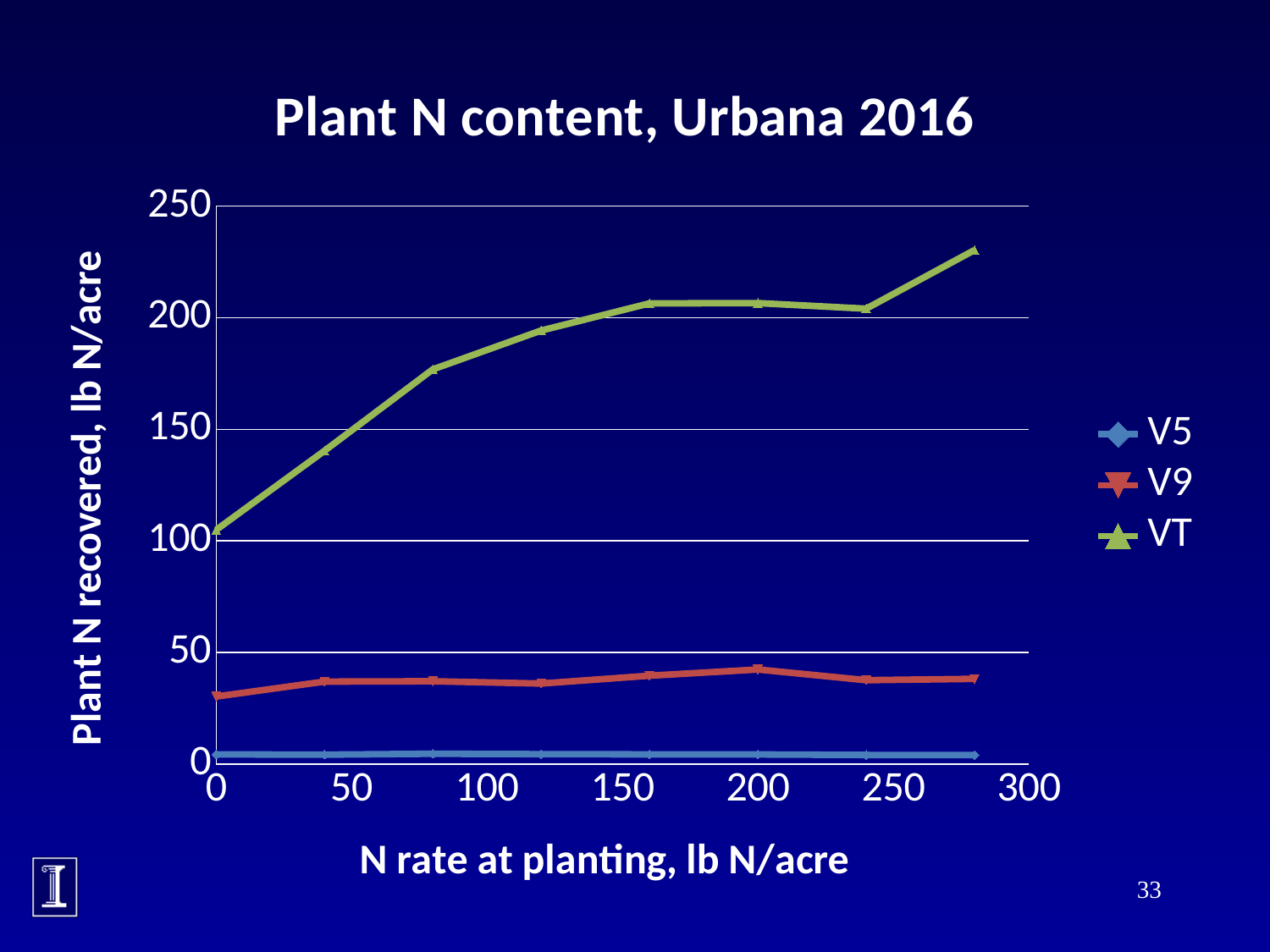
Which series has the highest plant N recovered at an N rate of 280 lb N/acre? VT Which series has the lowest plant N recovered across all N rates? V5 Is the V9 value at an N rate of 200 greater or less than 50? less What kind of chart is shown on the slide? line chart Is the VT value at an N rate of 0 greater or less than 150? less What is the title of the chart? Plant N content, Urbana 2016 Is the VT value at an N rate of 120 greater or less than 150? greater How many series does the legend list? 3 At an N rate of 160, which series has the larger value, VT or V9? VT How many data points are plotted for the VT series? 8 Does the VT series generally rise or fall as the N rate at planting increases? rise